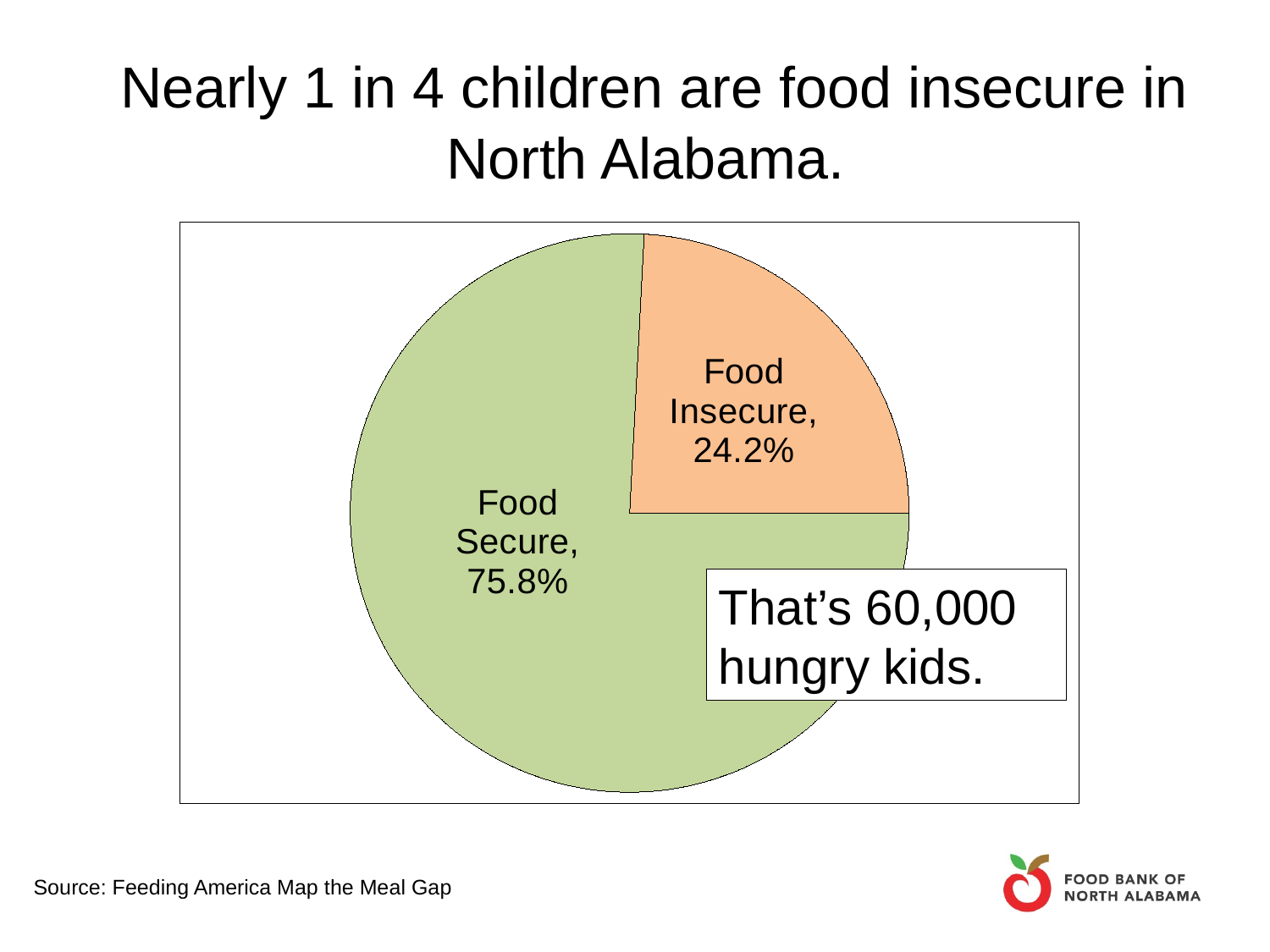
Which slice of the pie chart is the largest? Food Secure What colour is the Food Insecure slice of the pie chart? orange What is the difference in percentage points between the Food Secure and Food Insecure slices? 51.6 Which is larger, the Food Secure slice or the Food Insecure slice? Food Secure How many slices does the pie chart have? 2 What share of children are Food Secure according to the pie chart? 75.8% What colour is the Food Secure slice of the pie chart? green Is the Food Insecure share greater or less than 50%? less Which slice of the pie chart is the smallest? Food Insecure What share of children are Food Insecure according to the pie chart? 24.2% What kind of chart is shown on the slide? pie chart